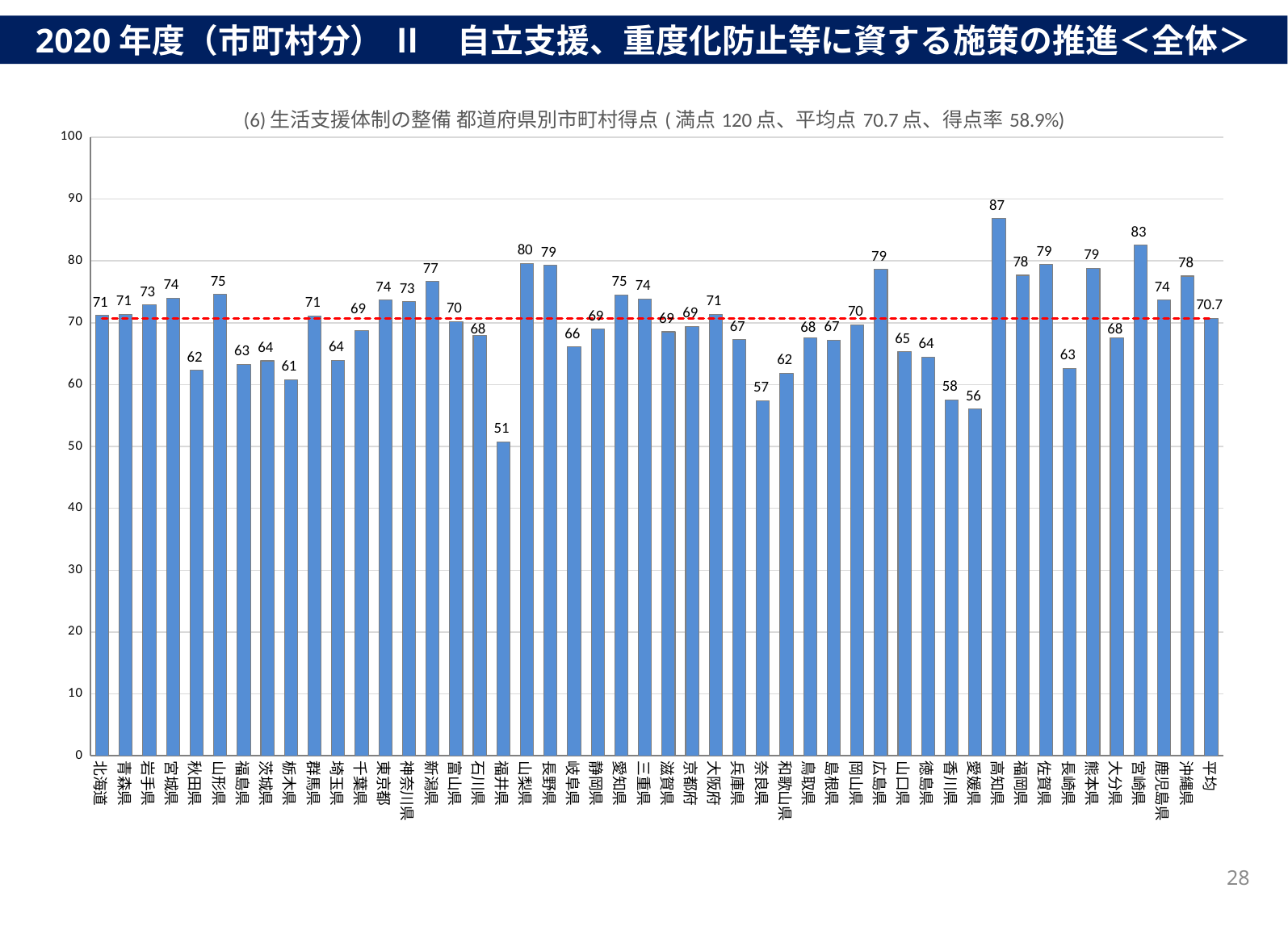
Is the value for 福井県 greater or less than 60? less Which is larger, the value for 宮崎県 or the value for 山梨県? 宮崎県 Which category has the highest value? 高知県 What is the value shown for 平均? 70.7 What is the value for 宮崎県? 83 What is the value for 福井県? 51 What is the difference between the values for 高知県 and 福井県? 36 What kind of chart is shown on the slide? bar chart What is the value for 高知県? 87 What is the 平均点 stated in the chart title? 70.7 点 Which category has the lowest value? 福井県 What is the difference between the values for 新潟県 and 奈良県? 20